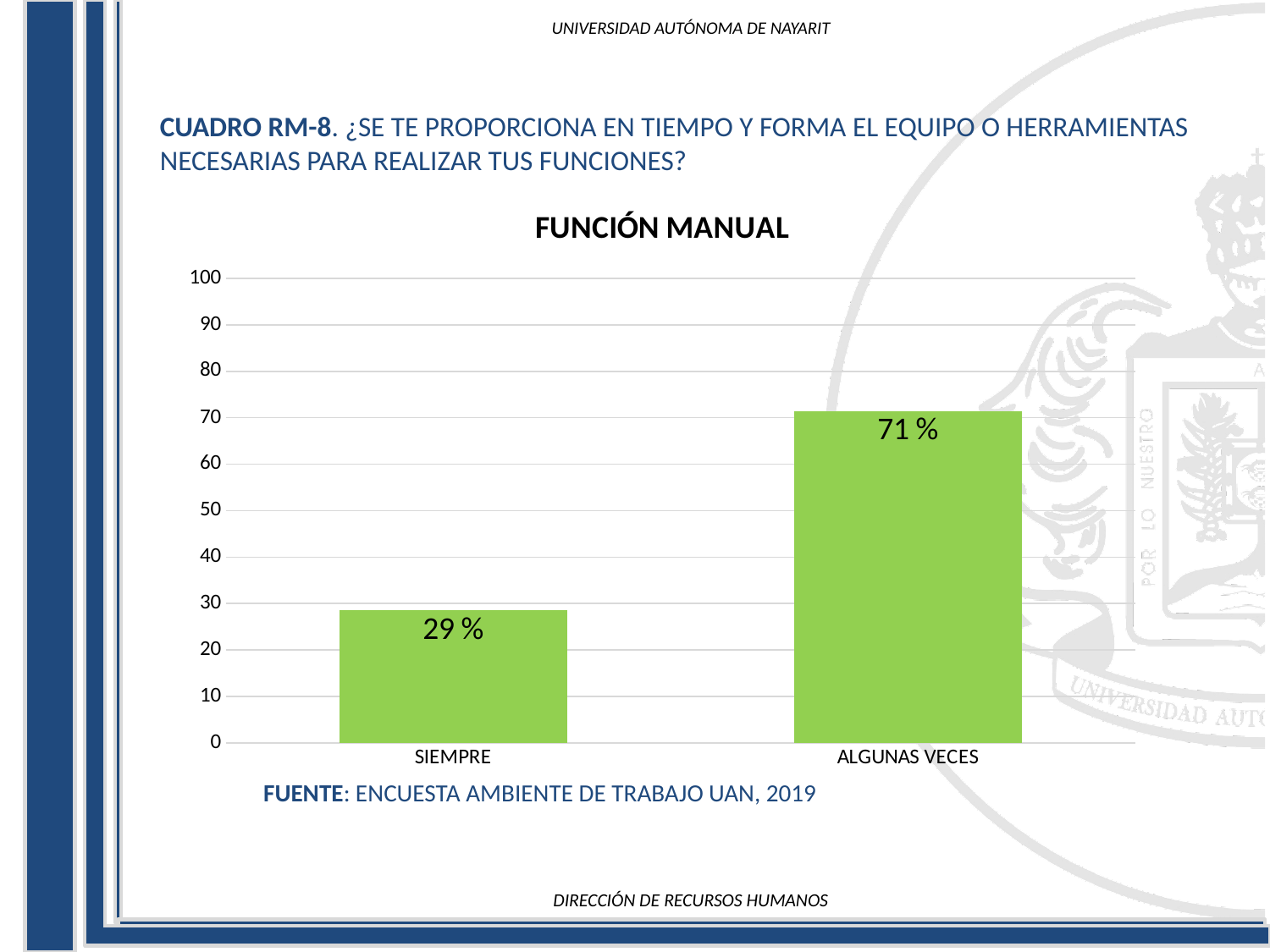
Is the value for SIEMPRE greater or less than 40? less What colour are the bars in the chart? green How many categories are shown on the x axis? 2 What is the value for ALGUNAS VECES? 71 % What kind of chart is shown on the slide? bar chart Is the value for ALGUNAS VECES greater or less than 60? greater Which category has the lowest value? SIEMPRE What is the title of the chart? FUNCIÓN MANUAL What is the difference between the values for ALGUNAS VECES and SIEMPRE? 42 % Which is larger, the value for SIEMPRE or the value for ALGUNAS VECES? ALGUNAS VECES What is the value for SIEMPRE? 29 % Which category has the highest value? ALGUNAS VECES